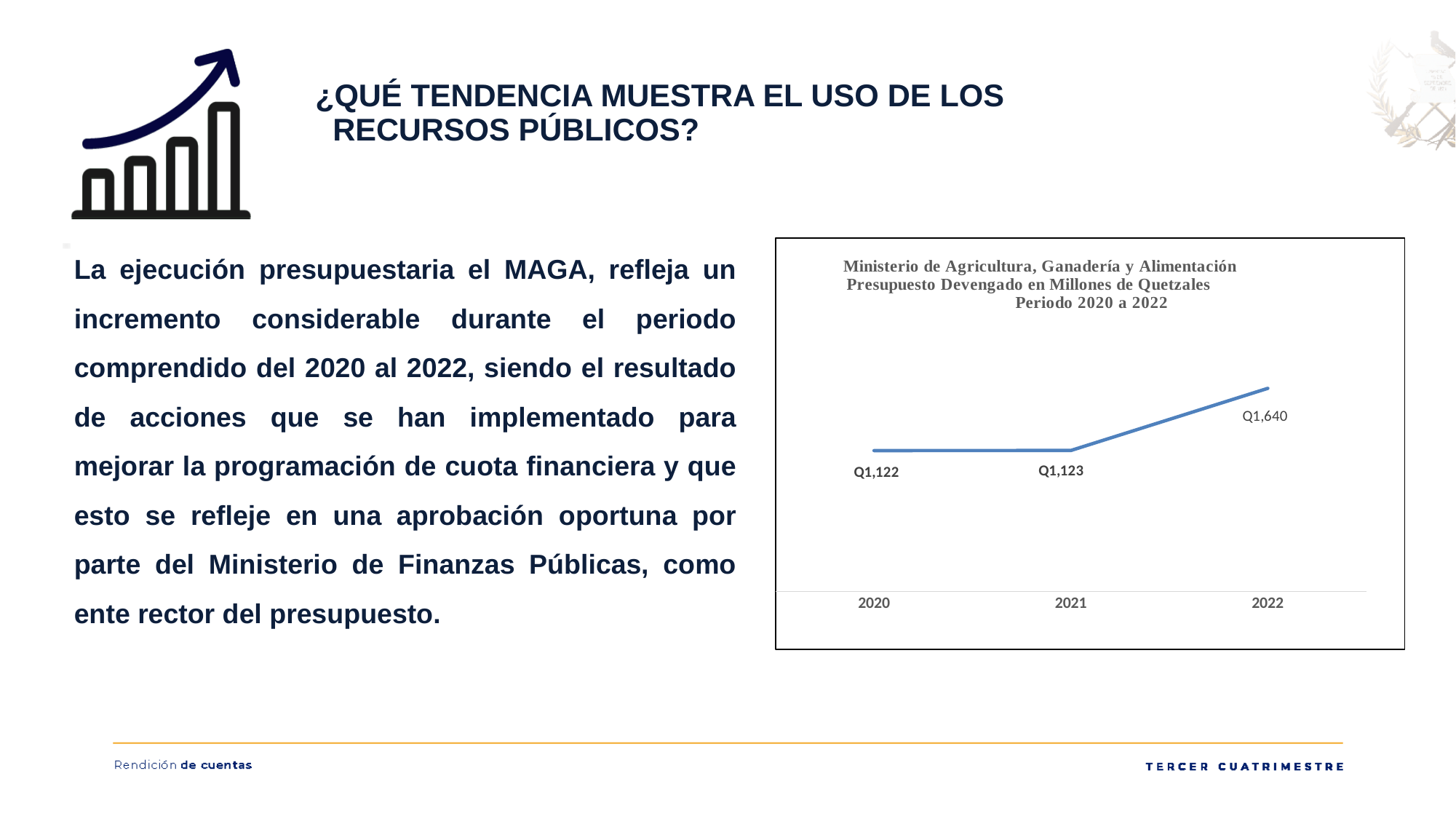
How many years are plotted on the chart? 3 Do the values rise or fall from 2020 to 2022? Rise What period does the chart title say it covers? Periodo 2020 a 2022 What kind of chart is shown on the slide? Line chart What is the difference between the values for 2022 and 2021? Q517 Which year has the highest value? 2022 Which year has the lowest value? 2020 What is the value for 2021? Q1,123 What is the value for 2020? Q1,122 What is the difference between the values for 2021 and 2020? Q1 Which is larger, the value for 2022 or the value for 2020? 2022 What is the value for 2022? Q1,640